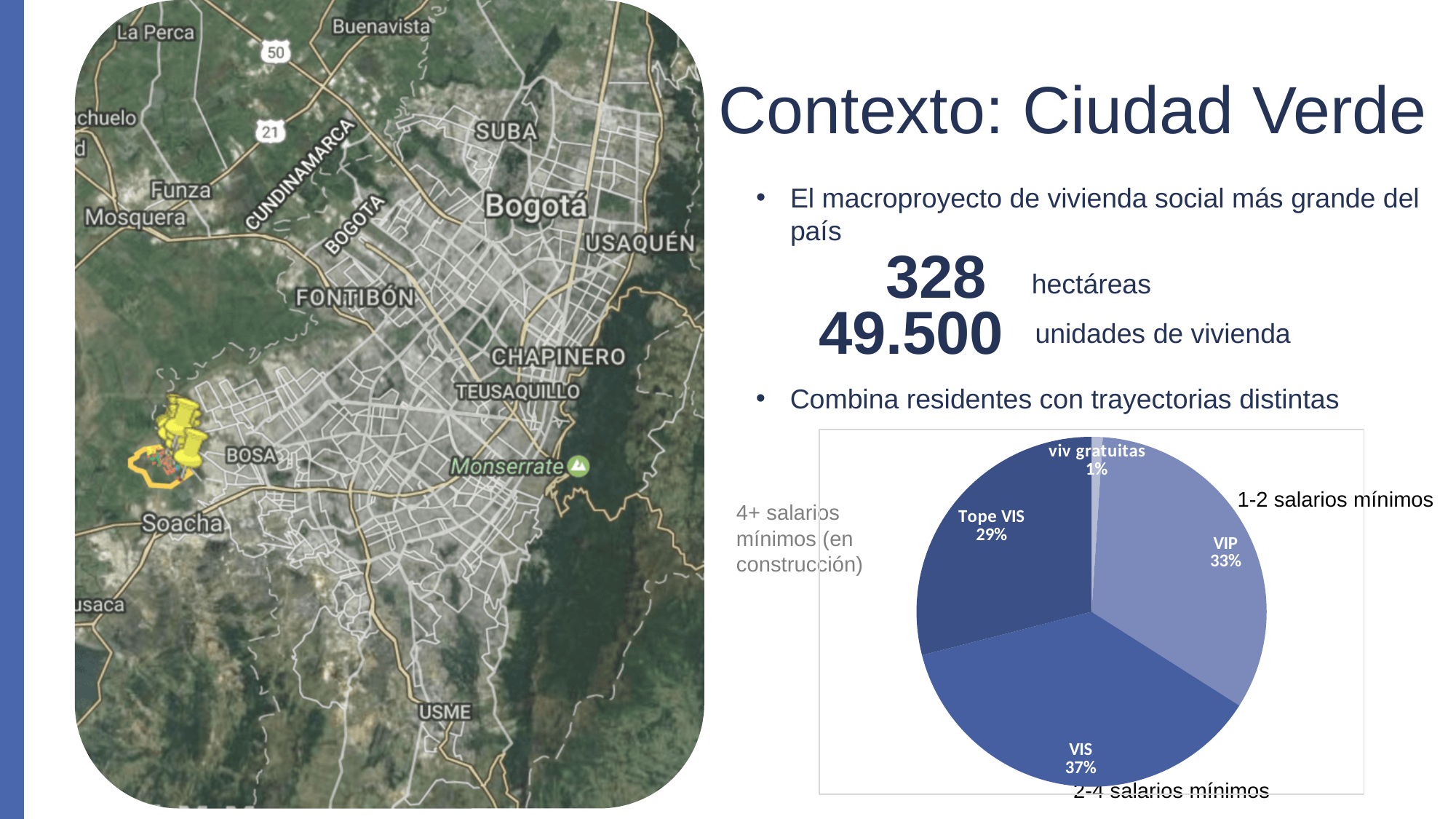
Which slice of the pie chart is the smallest? viv gratuitas What share of the pie does the Tope VIS slice represent? 29% Which slice of the pie chart is the largest? VIS How many slices does the pie chart have? 4 Which is larger, the VIP slice or the Tope VIS slice? VIP What is the difference in percentage points between the VIS and VIP slices? 4 What is the combined share of the VIS and Tope VIS slices? 66% What share of the pie does the viv gratuitas slice represent? 1% Which salary range annotation is placed next to the VIS slice? 2-4 salarios mínimos What share of the pie does the VIP slice represent? 33% What kind of chart is shown on the slide? pie chart